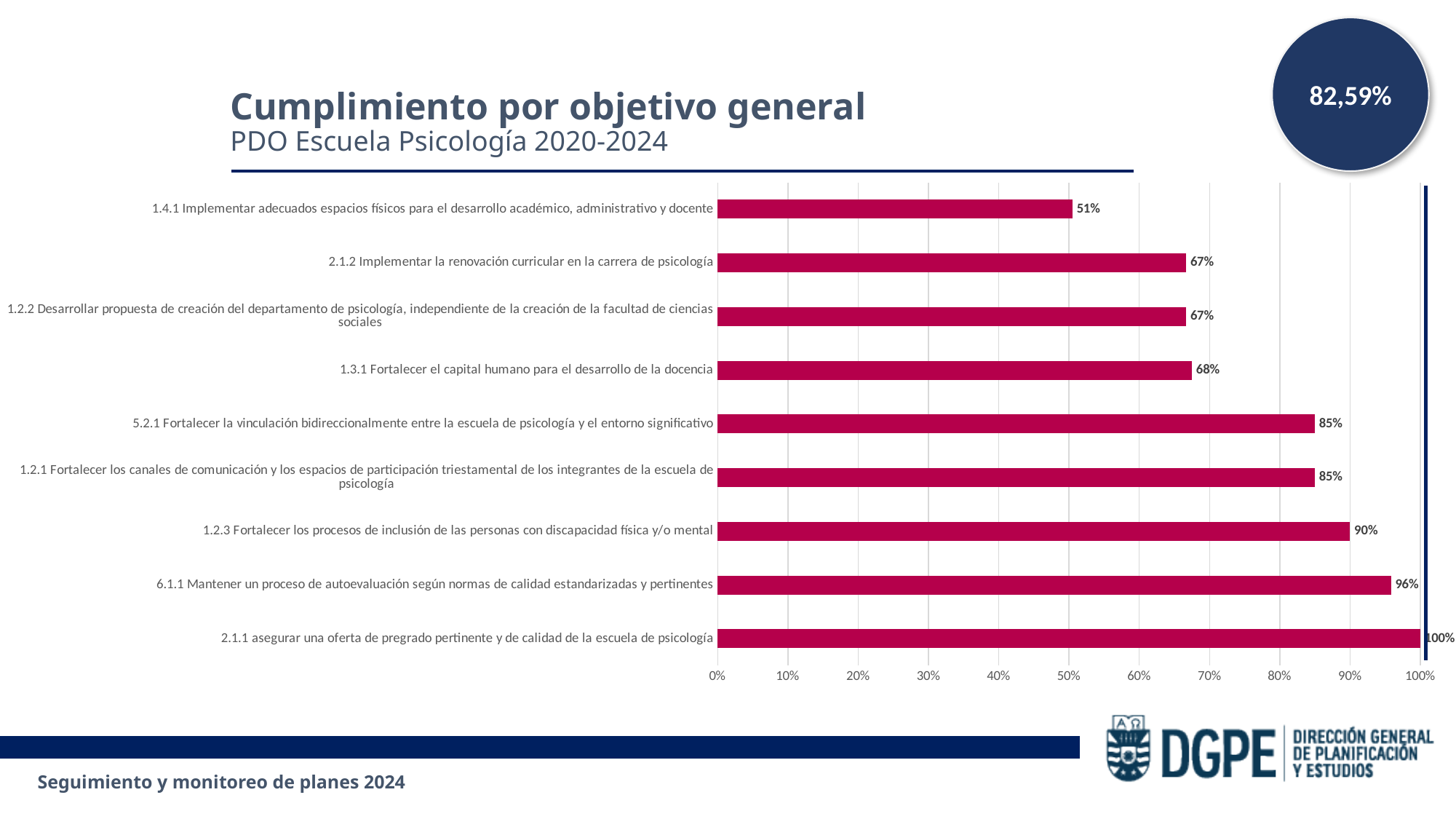
What is the value for objective 6.1.1 Mantener un proceso de autoevaluación según normas de calidad estandarizadas y pertinentes? 96% What is the value for objective 1.2.3 Fortalecer los procesos de inclusión de las personas con discapacidad física y/o mental? 90% Is the value for objective 2.1.2 Implementar la renovación curricular en la carrera de psicología greater or less than 80%? less Which objective has the lowest value in the chart? 1.4.1 Implementar adecuados espacios físicos para el desarrollo académico, administrativo y docente What is the difference between the value for objective 2.1.1 and the value for objective 1.4.1? 49% What percentage is shown in the circle at the top right of the slide? 82,59% What kind of chart is shown on the slide? bar chart Which objective has the highest value in the chart? 2.1.1 asegurar una oferta de pregrado pertinente y de calidad de la escuela de psicología What is the title of the chart? Cumplimiento por objetivo general What is the value for objective 1.4.1 Implementar adecuados espacios físicos para el desarrollo académico, administrativo y docente? 51% How many objectives are plotted in the chart? 9 Which is larger, the value for objective 1.3.1 Fortalecer el capital humano para el desarrollo de la docencia or the value for objective 5.2.1 Fortalecer la vinculación bidireccionalmente entre la escuela de psicología y el entorno significativo? 5.2.1 Fortalecer la vinculación bidireccionalmente entre la escuela de psicología y el entorno significativo